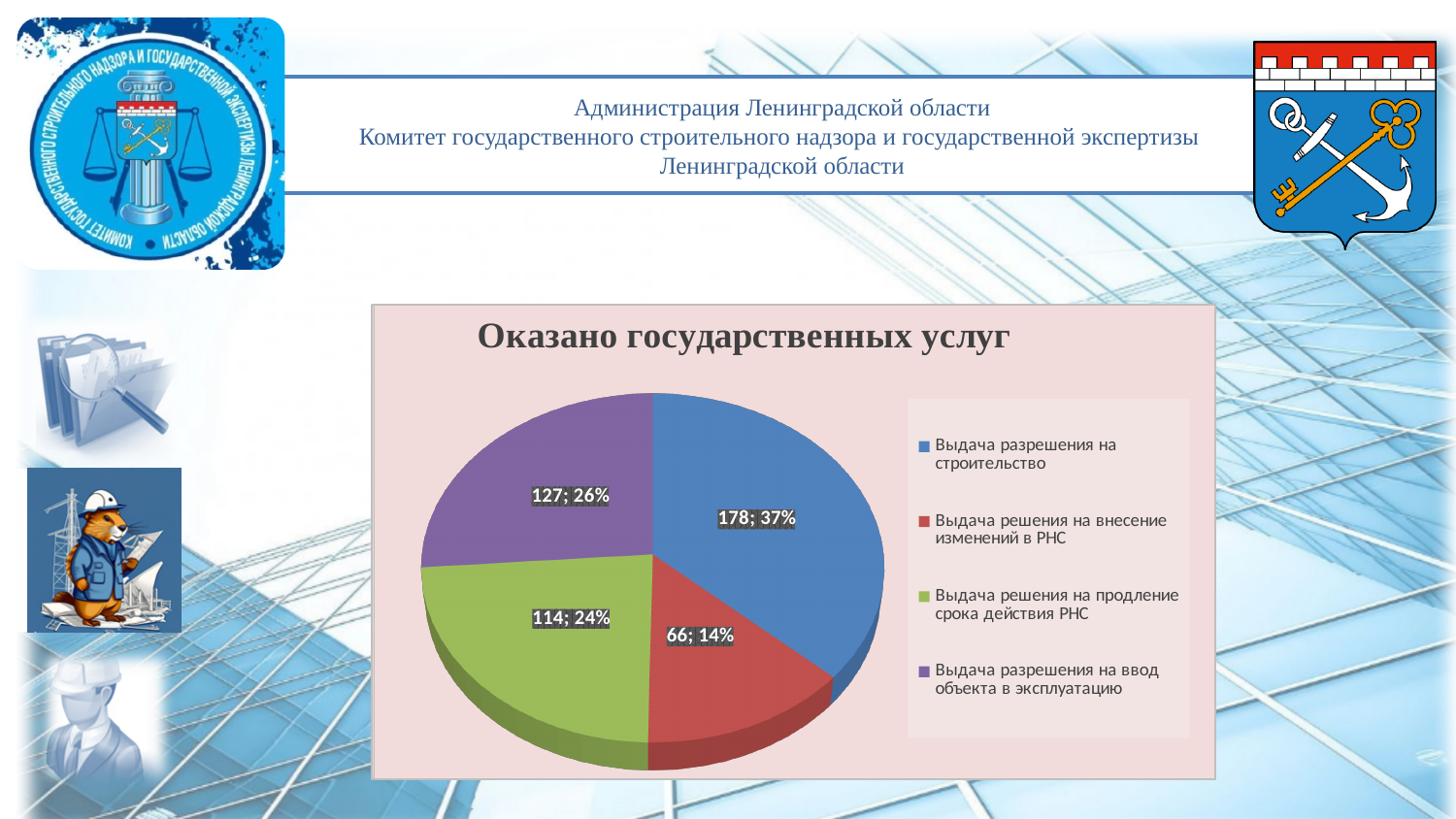
What is the value for "Выдача решения на внесение изменений в РНС"? 66 What is the value for "Выдача решения на продление срока действия РНС"? 114 What type of chart is shown on the slide? pie chart What is the difference between the values for "Выдача разрешения на строительство" and "Выдача решения на внесение изменений в РНС"? 112 What is the value for "Выдача разрешения на строительство"? 178 How many entries does the legend list? 4 How many slices does the pie chart have? 4 What is the value for "Выдача разрешения на ввод объекта в эксплуатацию"? 127 What share of the pie does "Выдача разрешения на ввод объекта в эксплуатацию" represent? 26% Which category has the smallest slice? Выдача решения на внесение изменений в РНС What is the title of the chart? Оказано государственных услуг Which category has the largest slice? Выдача разрешения на строительство